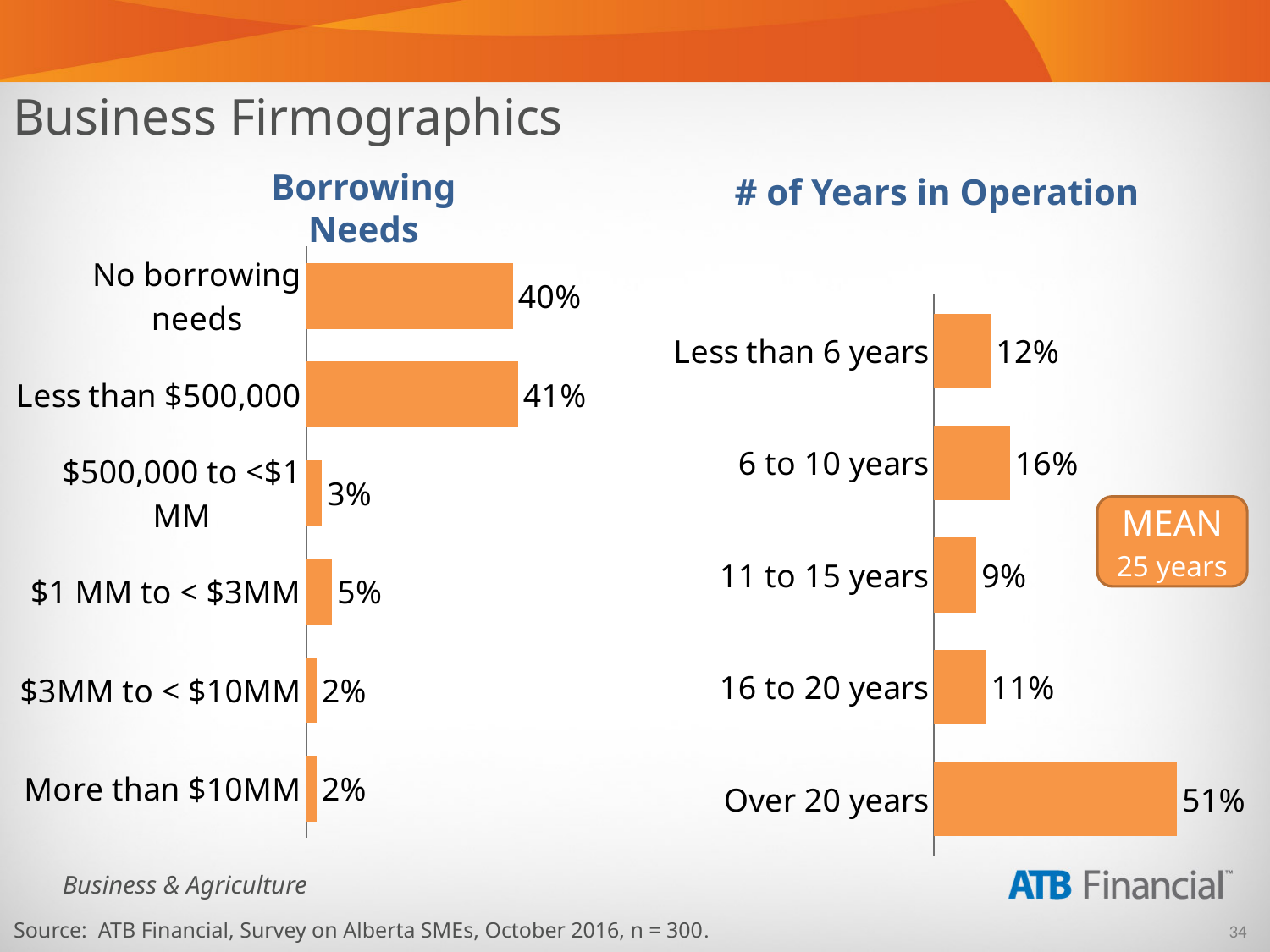
In the Borrowing Needs chart, what is the value for Less than $500,000? 41% In the # of Years in Operation chart, which category has the highest value? Over 20 years In the Borrowing Needs chart, how many categories are shown? 6 What mean number of years in operation is shown next to the # of Years in Operation chart? 25 years In the # of Years in Operation chart, which is larger: the value for Less than 6 years or the value for 16 to 20 years? Less than 6 years In the # of Years in Operation chart, what is the difference between the values for Over 20 years and 6 to 10 years? 35% In the # of Years in Operation chart, which category has the lowest value? 11 to 15 years In the Borrowing Needs chart, which category has the highest value? Less than $500,000 In the # of Years in Operation chart, what is the value for 6 to 10 years? 16% What type of chart is the # of Years in Operation chart? Bar chart In the Borrowing Needs chart, what is the difference between the values for $1 MM to < $3MM and $500,000 to <$1 MM? 2% In the Borrowing Needs chart, what percentage of businesses have no borrowing needs? 40%